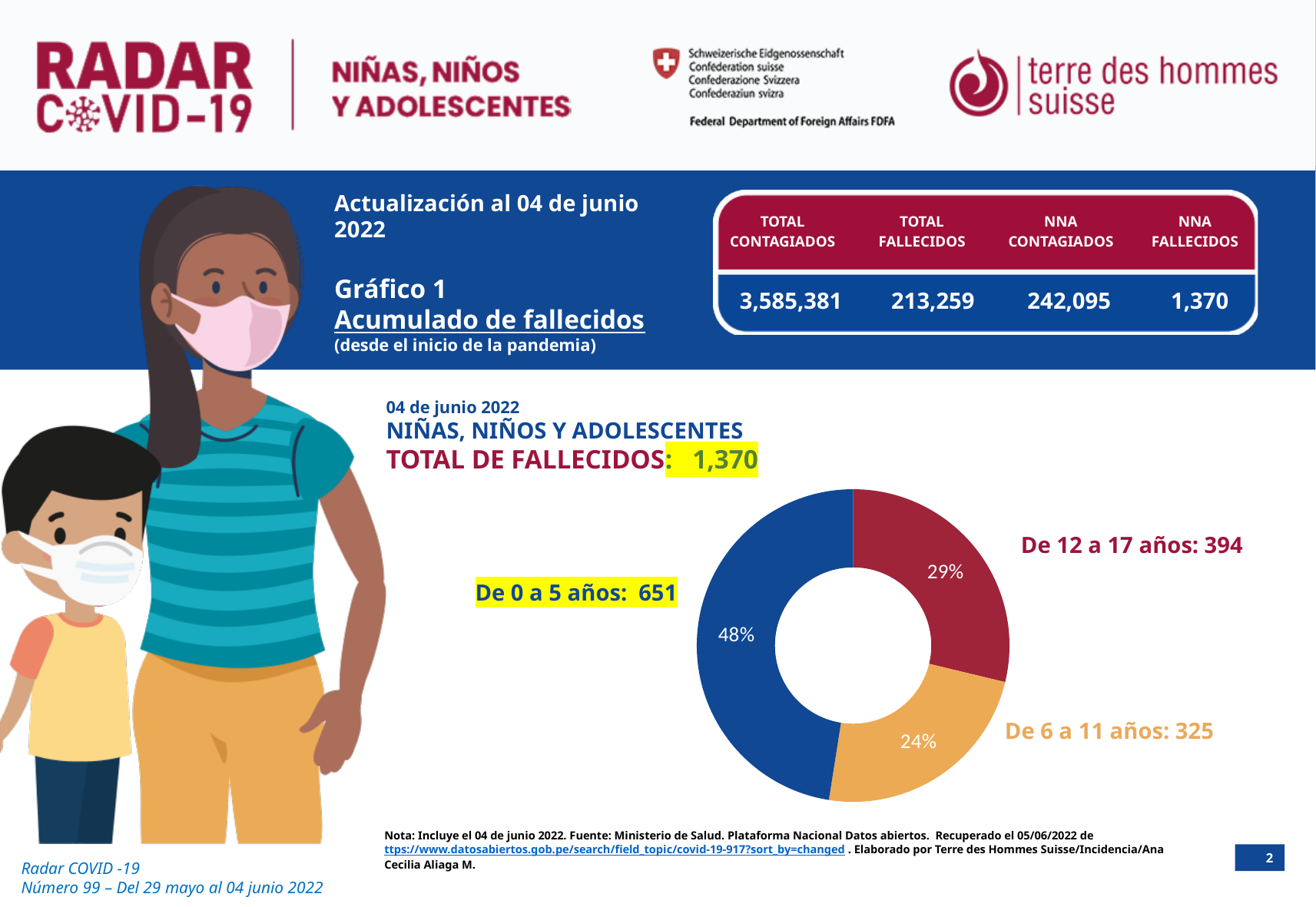
What is the total number of deaths shown for niñas, niños y adolescentes? 1,370 What kind of chart is shown on the slide? Donut (pie) chart What is the difference in deaths between the 'De 0 a 5 años' group and the 'De 12 a 17 años' group? 257 What percentage share of the donut chart does the 'De 6 a 11 años' group represent? 24% What is the number of deaths for the group 'De 12 a 17 años'? 394 Which age group has the lowest number of deaths in the donut chart? De 6 a 11 años What is the number of deaths for the group 'De 0 a 5 años'? 651 Which age group has the highest number of deaths in the donut chart? De 0 a 5 años How many age groups does the donut chart show? 3 What is the number of deaths for the group 'De 6 a 11 años'? 325 What percentage share of the donut chart does the 'De 12 a 17 años' group represent? 29% What percentage share of the donut chart does the 'De 0 a 5 años' group represent? 48%